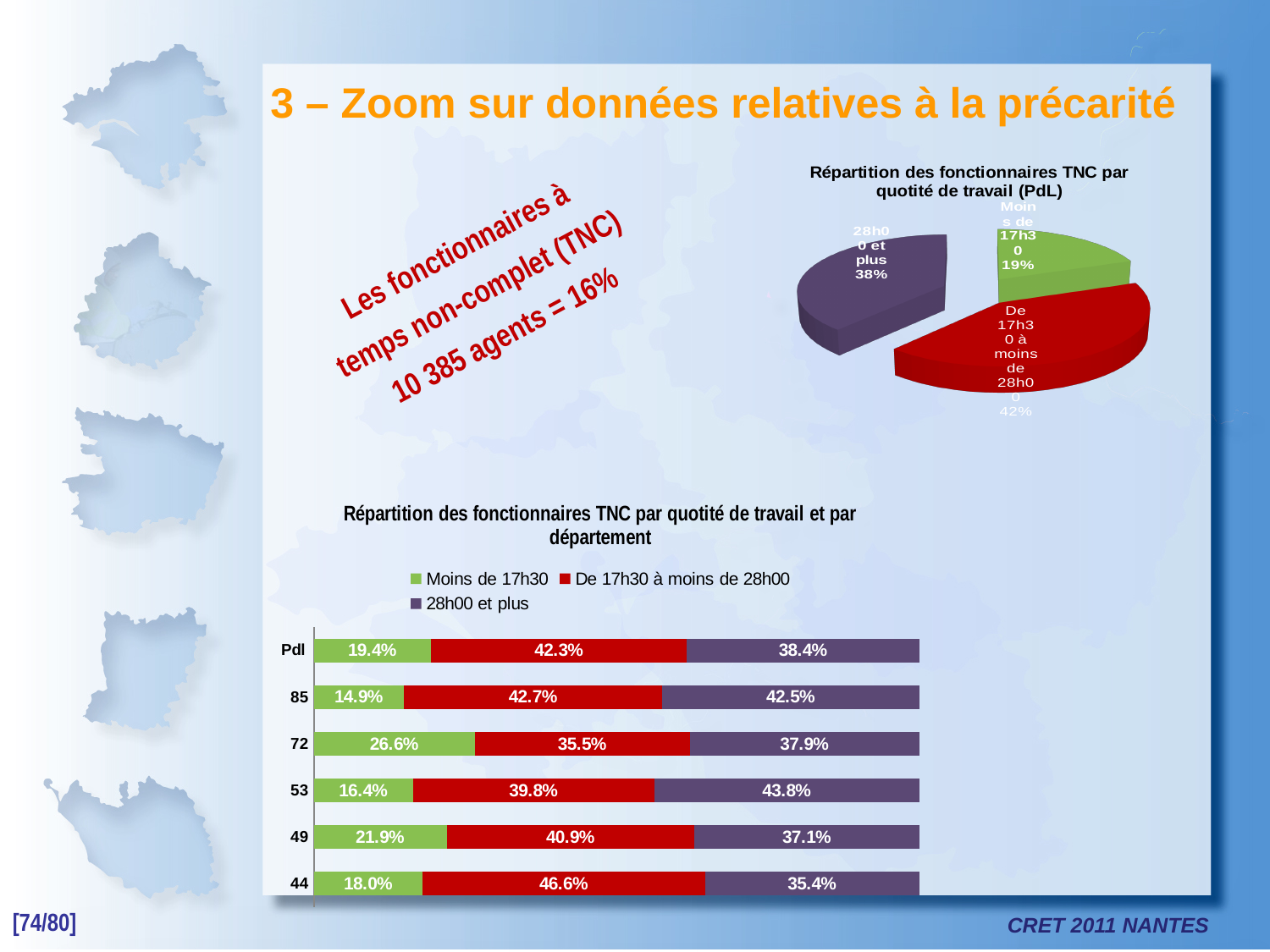
In the bar chart 'Répartition des fonctionnaires TNC par quotité de travail et par département', which category has the lowest 'Moins de 17h30' share? 85 In the bar chart 'Répartition des fonctionnaires TNC par quotité de travail et par département', what is the difference between the 'De 17h30 à moins de 28h00' values for department 44 and department 72? 11.1% In the pie chart 'Répartition des fonctionnaires TNC par quotité de travail (PdL)', which slice is the largest? De 17h30 à moins de 28h00 What kind of chart is 'Répartition des fonctionnaires TNC par quotité de travail (PdL)'? Pie chart In the bar chart 'Répartition des fonctionnaires TNC par quotité de travail et par département', which department has the highest 'Moins de 17h30' share? 72 In the pie chart 'Répartition des fonctionnaires TNC par quotité de travail (PdL)', what share does '28h00 et plus' have? 38% How many series does the legend of the bar chart 'Répartition des fonctionnaires TNC par quotité de travail et par département' list? 3 In the bar chart 'Répartition des fonctionnaires TNC par quotité de travail et par département', what is the value of '28h00 et plus' for department 53? 43.8% In the bar chart 'Répartition des fonctionnaires TNC par quotité de travail et par département', what is the value of 'Moins de 17h30' for department 72? 26.6% In the bar chart 'Répartition des fonctionnaires TNC par quotité de travail et par département', what is the value of 'De 17h30 à moins de 28h00' for department 44? 46.6% In the bar chart 'Répartition des fonctionnaires TNC par quotité de travail et par département', which is larger: the '28h00 et plus' value for department 85 or for department 49? 85 How many categories are shown in the bar chart 'Répartition des fonctionnaires TNC par quotité de travail et par département'? 6